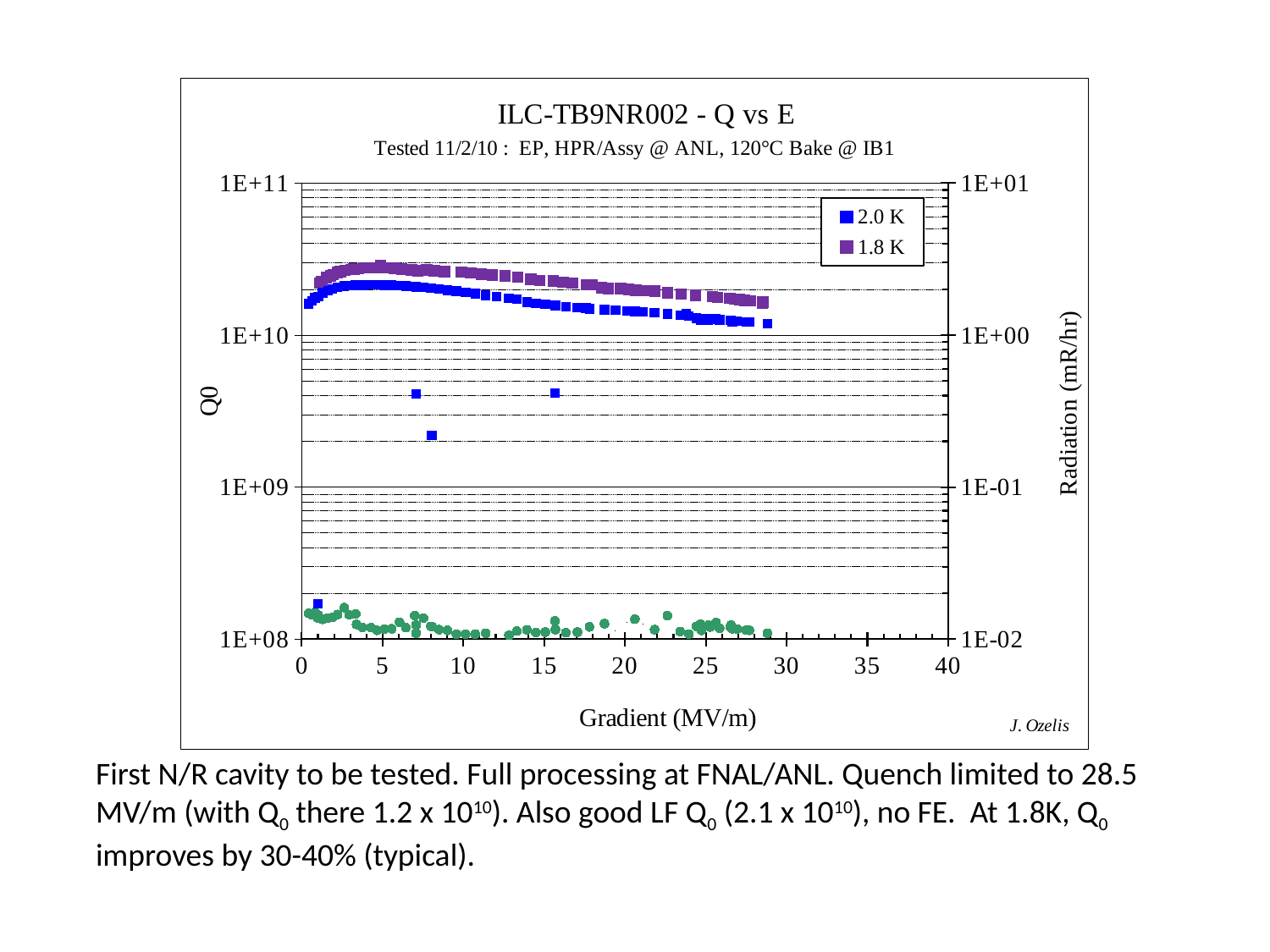
What is the highest tick value shown on the left Q0 axis? 1E+11 Does the Q0 of the 2.0 K series rise or fall as the gradient increases from 10 to 28 MV/m? fall What kind of chart is shown on the slide? scatter chart Which two series are listed in the chart's legend? 2.0 K and 1.8 K Is the Q0 of the 2.0 K series at a gradient of 25 MV/m greater or less than 1E+10? greater What is the highest tick value shown on the x axis? 40 Is the Q0 of the 1.8 K series at a gradient of 5 MV/m greater or less than 1E+10? greater What is the title of the chart? ILC-TB9NR002 - Q vs E How many series does the chart's legend list? 2 What is the label of the right-hand y axis? Radiation (mR/hr) At a gradient of 20 MV/m, which series has the higher Q0, 1.8 K or 2.0 K? 1.8 K What is the label of the x axis? Gradient (MV/m)